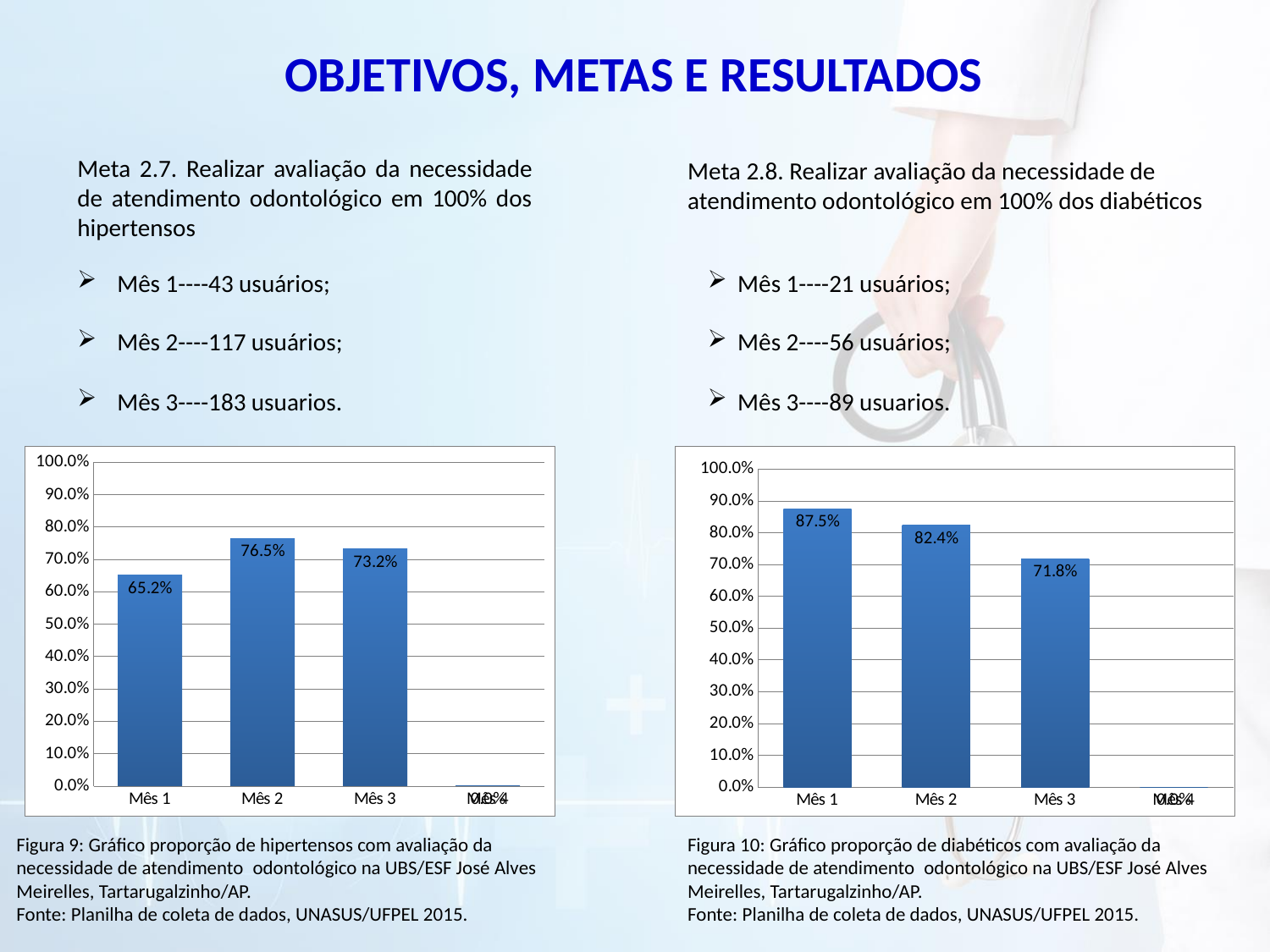
In the left chart (Figura 9, hipertensos), what is the value for Mês 2? 76.5% In the left chart (Figura 9, hipertensos), what is the difference between the values for Mês 2 and Mês 1? 11.3 percentage points In the left chart (Figura 9, hipertensos), which month has the highest value? Mês 2 In the right chart (Figura 10, diabéticos), what is the difference between the values for Mês 1 and Mês 3? 15.7 percentage points What kind of chart is the left chart (Figura 9, hipertensos)? bar chart In the left chart (Figura 9, hipertensos), which is larger, the value for Mês 2 or Mês 3? Mês 2 In the right chart (Figura 10, diabéticos), is the value for Mês 2 greater or less than 80.0%? greater In the right chart (Figura 10, diabéticos), which month has the highest value? Mês 1 In the right chart (Figura 10, diabéticos), which of Mês 1, Mês 2 and Mês 3 has the lowest value? Mês 3 In the left chart (Figura 9, hipertensos), what is the value for Mês 1? 65.2% In the right chart (Figura 10, diabéticos), do the values rise or fall from Mês 1 to Mês 3? fall In the right chart (Figura 10, diabéticos), what is the value for Mês 3? 71.8%